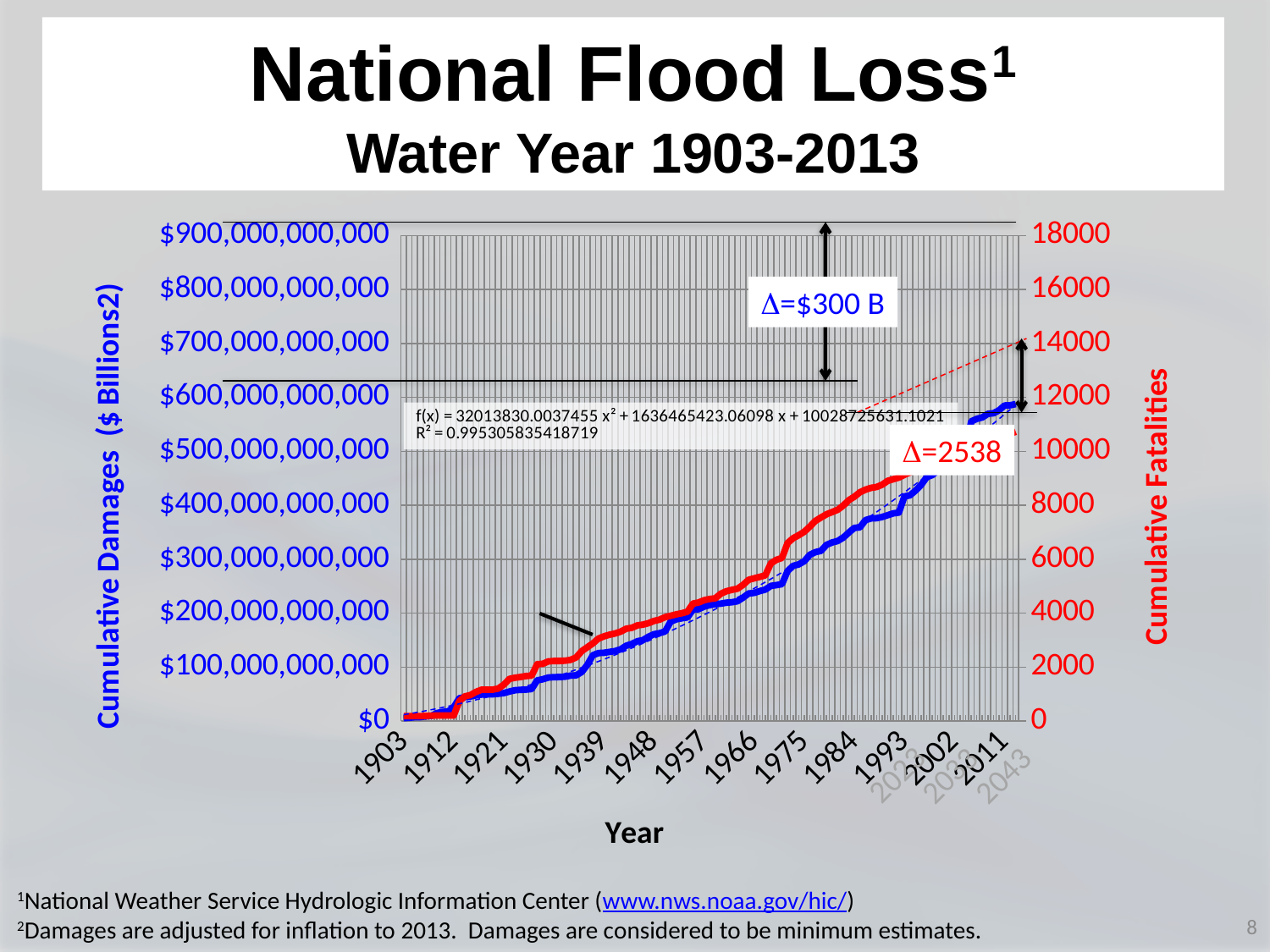
What difference (Δ) in cumulative damages is labelled on the chart? $300 B What R² value is printed for the trendline on the chart? 0.995305835418719 What kind of chart is shown on the slide? line chart Is the cumulative damages value at 2011 greater or less than $500,000,000,000? greater What is the label of the x axis? Year What is the highest tick value shown on the left (Cumulative Damages) axis? $900,000,000,000 Is the cumulative fatalities value at 1975 greater or less than 4000? greater What is the highest tick value shown on the right (Cumulative Fatalities) axis? 18000 What difference (Δ) in cumulative fatalities is labelled on the chart? 2538 What is the title of the chart on the slide? National Flood Loss Water Year 1903-2013 Do the cumulative damages rise or fall as the year increases along the x axis? rise Is the cumulative damages value at 1948 greater or less than $300,000,000,000? less